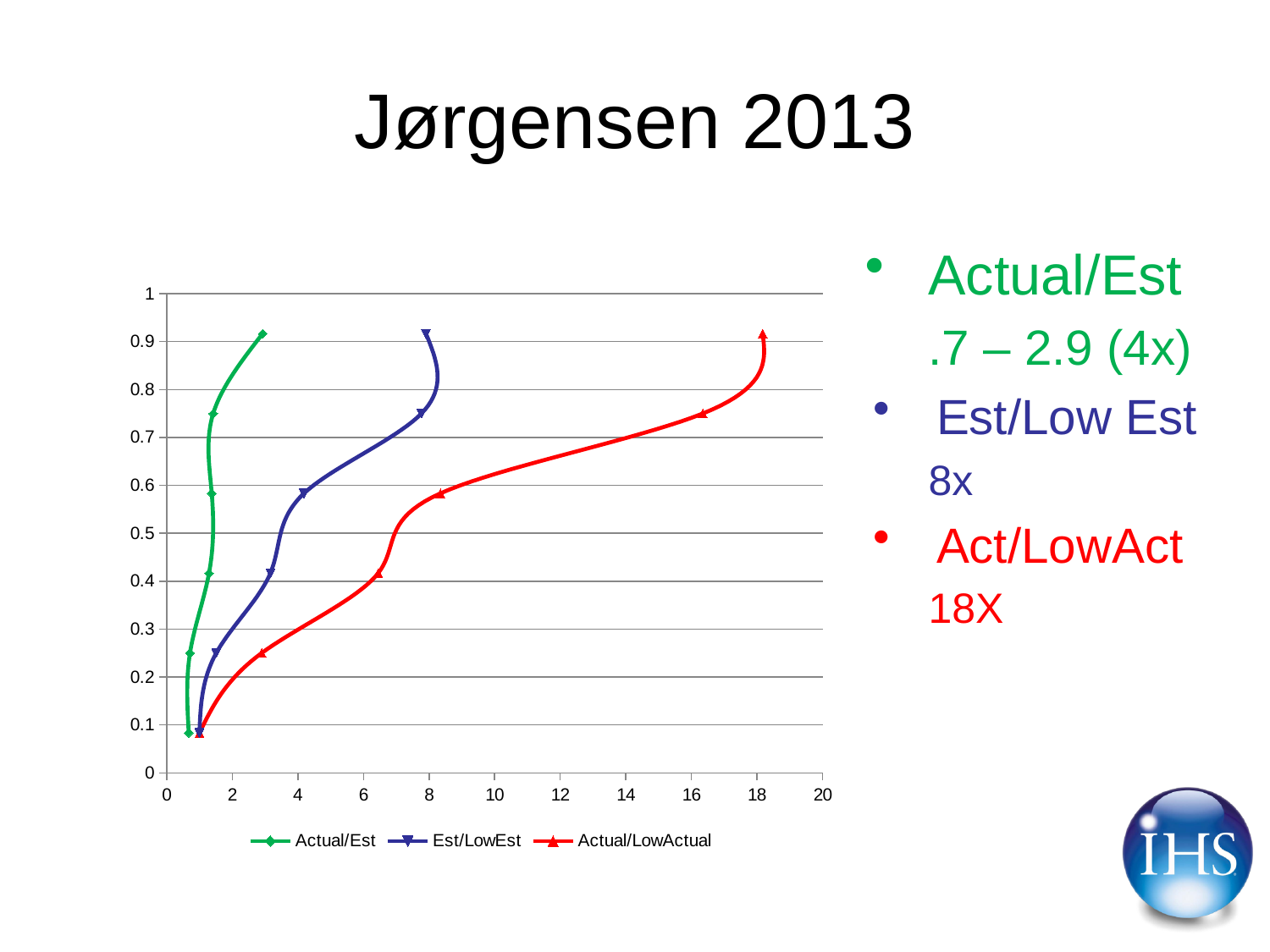
Is the x value of the topmost Actual/Est point greater or less than 4? less What are the three series named in the chart legend? Actual/Est, Est/LowEst, Actual/LowActual Which series reaches the highest value on the x axis? Actual/LowActual Is the x value of the topmost Actual/LowActual point greater or less than 16? greater Which colour is used for the Actual/LowActual series in the chart? red Which series stays at the lowest x-axis values across the chart? Actual/Est Is the x value of the topmost Est/LowEst point greater or less than 6? greater As the x values increase along the Actual/LowActual series, do the y values rise or fall? rise At the topmost point of each series, which has the larger x value: Est/LowEst or Actual/LowActual? Actual/LowActual What kind of chart is shown on the slide? line chart How many data points are plotted for the Actual/Est series? 6 How many series does the chart legend list? 3